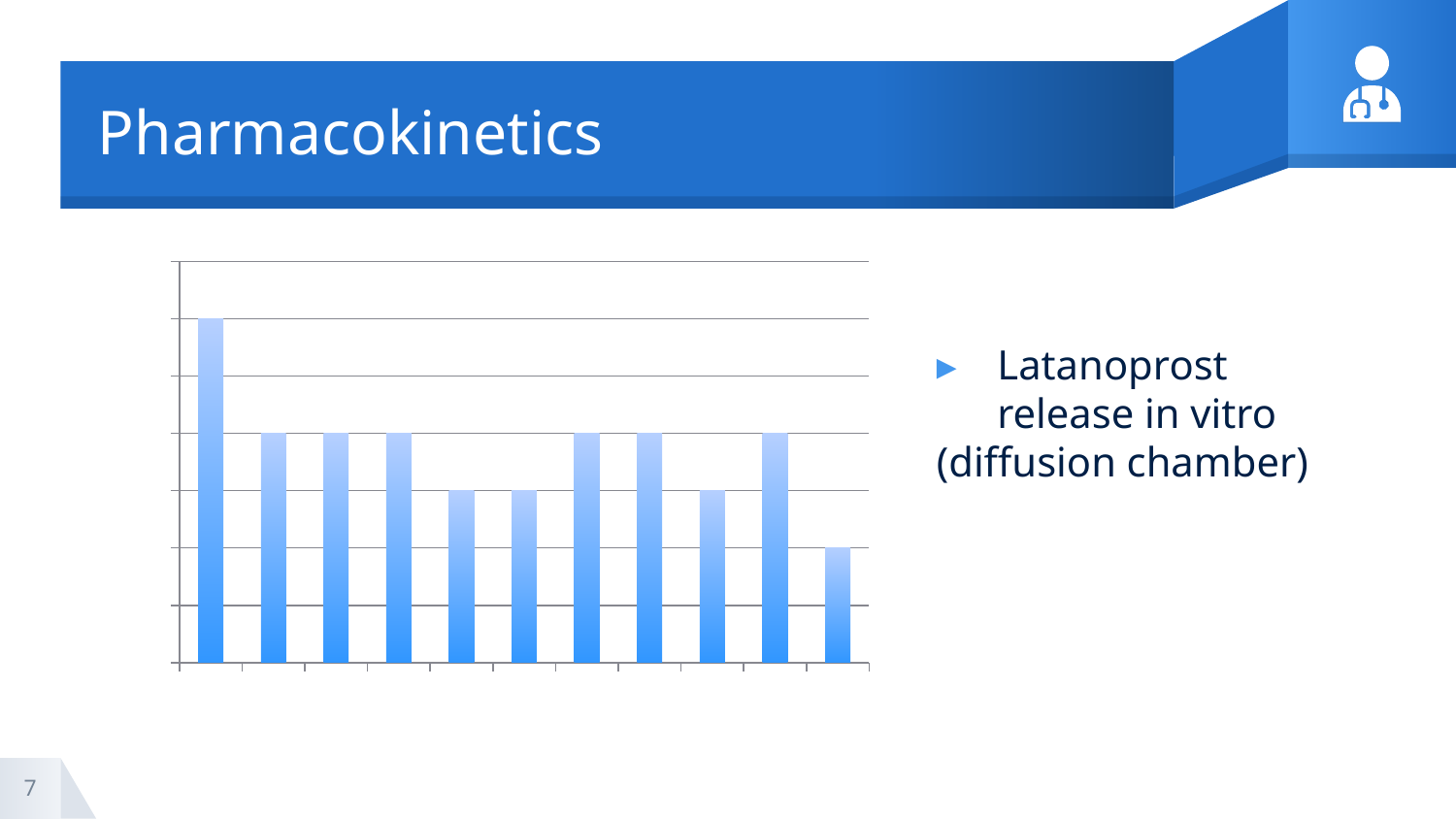
Which is taller, the tenth bar from the left or the eleventh bar from the left? the tenth bar Which is taller, the leftmost bar or the rightmost bar? the leftmost bar What colour are the bars in the chart? blue What kind of chart is shown on the slide? bar chart Does the chart have a legend? No Which bar in the chart is the tallest? the leftmost (first) bar How many bars are plotted in the chart? 11 Which is taller, the second bar from the left or the fifth bar from the left? the second bar Which bar in the chart is the shortest? the rightmost (last) bar